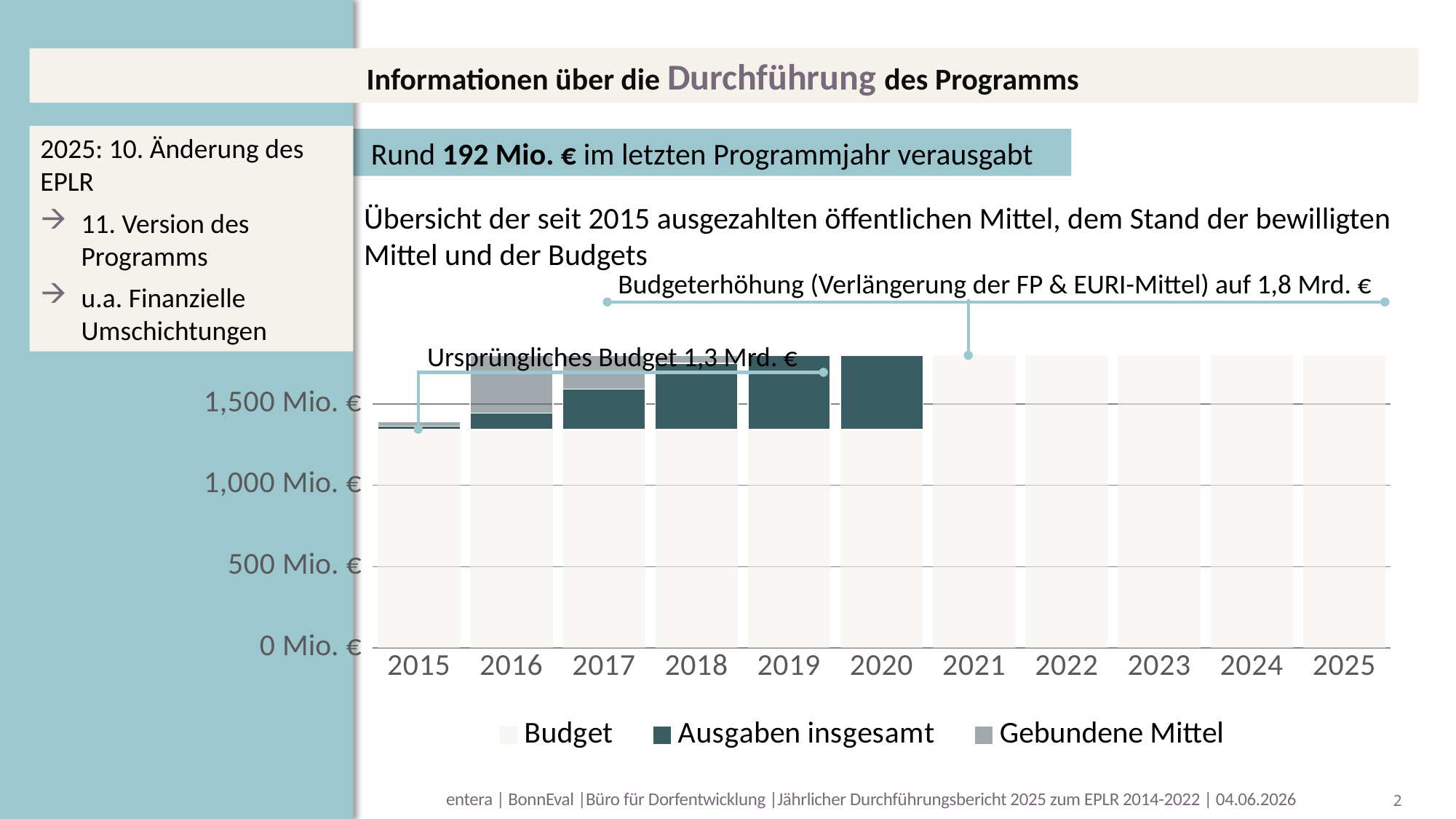
How many years are shown on the x axis of the chart? 11 According to the highlighted text above the chart, roughly how much was spent in the last programme year? 192 Mio. € What kind of chart is shown on the slide? bar chart Do the bars for Ausgaben insgesamt rise or fall from 2015 to 2020? rise What is the last year shown on the x axis of the chart? 2025 What are the three series named in the chart legend? Budget, Ausgaben insgesamt, Gebundene Mittel According to the annotation on the chart, what was the original budget (Ursprüngliches Budget)? 1,3 Mrd. € How many series does the chart legend list? 3 What is the highest tick label shown on the y axis of the chart? 1,500 Mio. € According to the annotation on the chart, to what amount was the budget increased (Budgeterhöhung)? 1,8 Mrd. € What is the first year shown on the x axis of the chart? 2015 Which year has the smallest bar for Ausgaben insgesamt? 2015